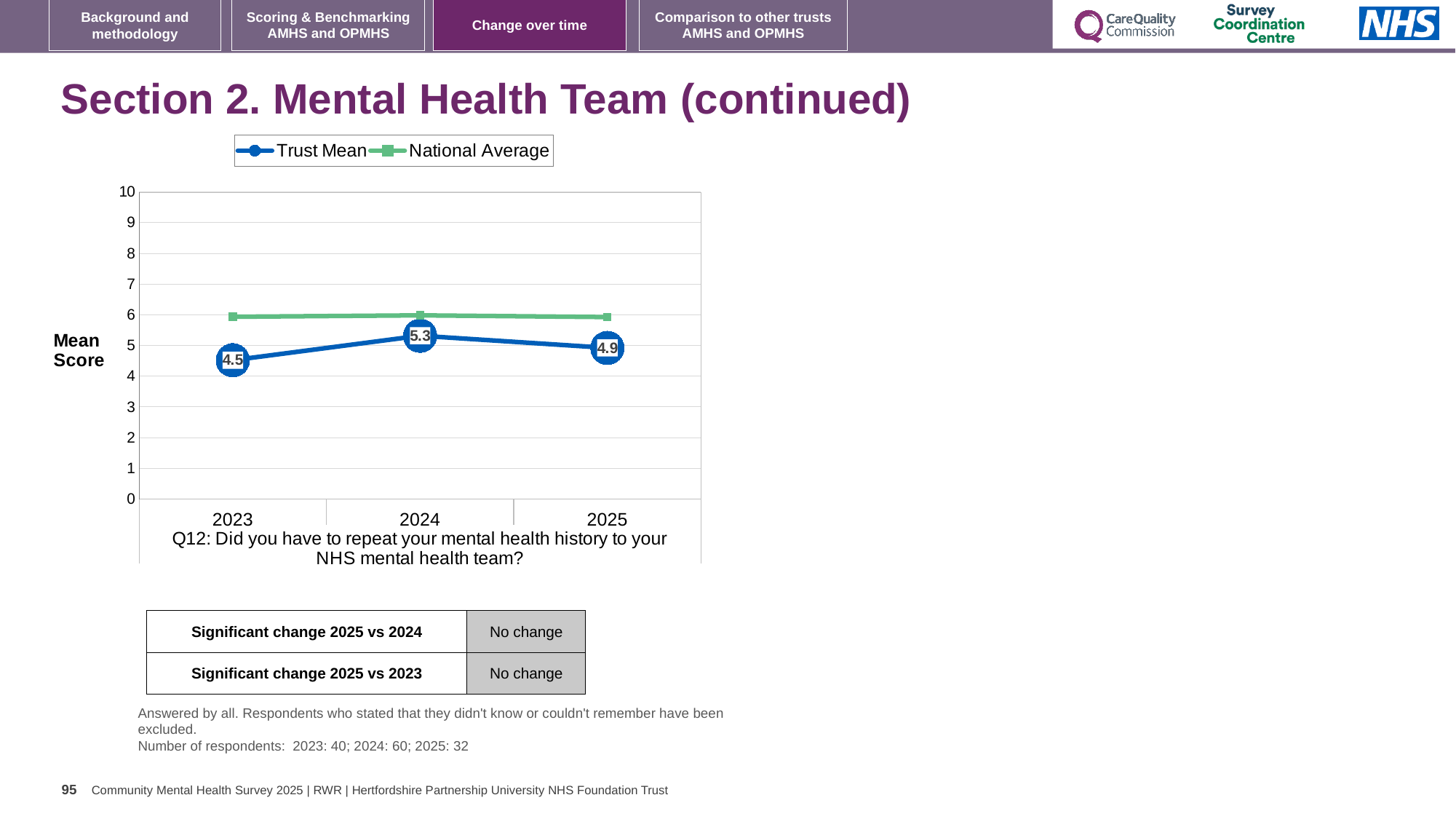
In which year is the Trust Mean lowest? 2023 Is the National Average value for 2024 greater or less than 5? greater Does the Trust Mean rise or fall from 2024 to 2025? Fall How many series does the legend list? 2 What is the Trust Mean score for 2025? 4.9 What is the Trust Mean score for 2024? 5.3 In which year is the Trust Mean highest? 2024 What kind of chart is shown on the slide? Line chart How many years are plotted on the x axis? 3 Which is larger in 2023, the Trust Mean or the National Average? National Average What is the difference between the Trust Mean in 2024 and in 2023? 0.8 What is the Trust Mean score for 2023? 4.5